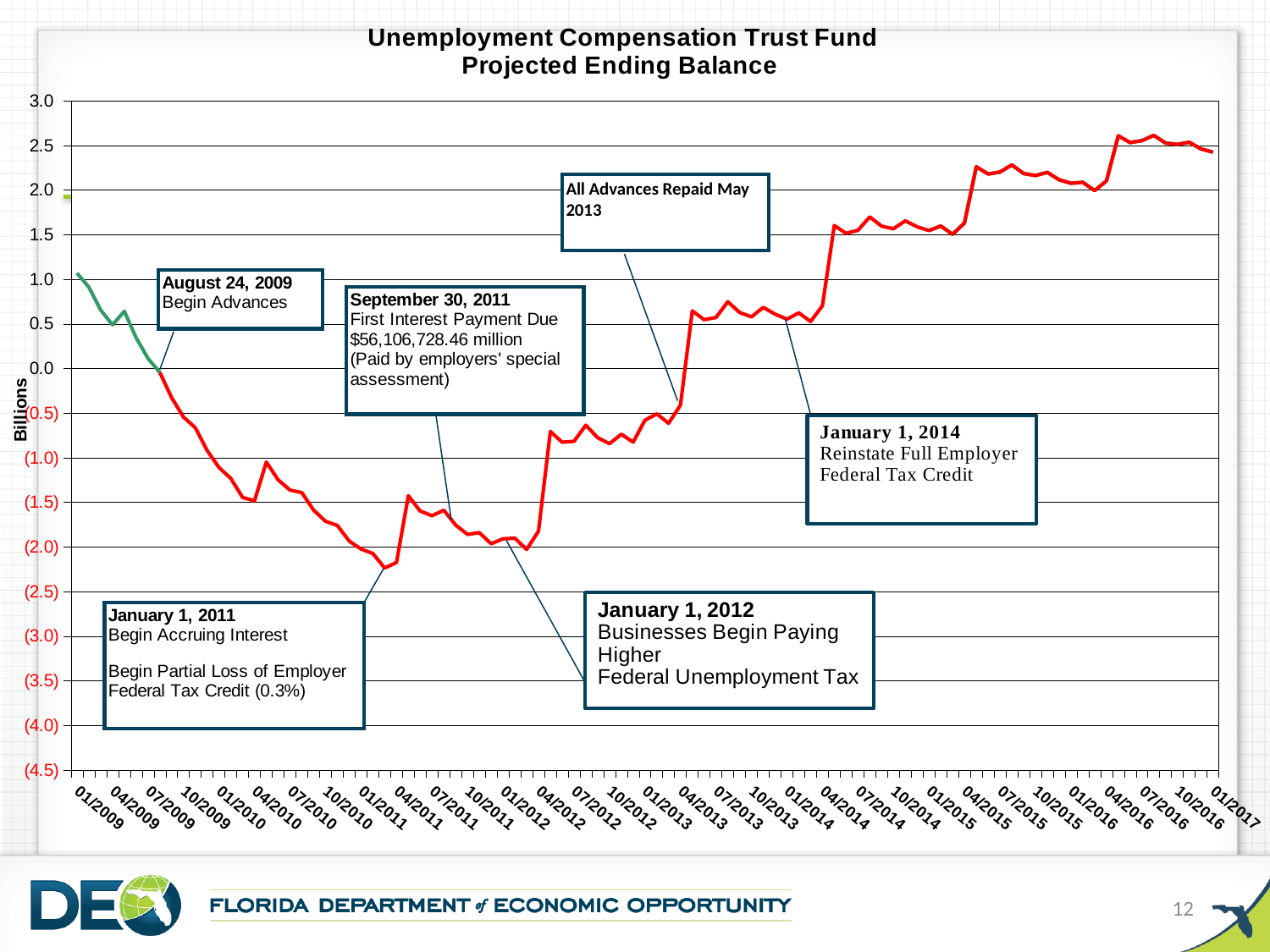
What kind of chart is shown on the slide? line chart Is the projected ending balance at 01/2014 greater or less than 0.0? greater Does the projected ending balance rise or fall overall between 01/2012 and 01/2017? rise In which year does the line reach its lowest point? 2011 Is the projected ending balance at 01/2010 greater or less than (1.0)? less What is the title of the chart? Unemployment Compensation Trust Fund Projected Ending Balance What unit does the y-axis label give for the values? Billions Is the projected ending balance at 01/2011 greater or less than (1.5)? less Does the projected ending balance rise or fall between 01/2009 and 01/2011? fall Which is larger, the projected ending balance at 01/2017 or at 01/2009? 01/2017